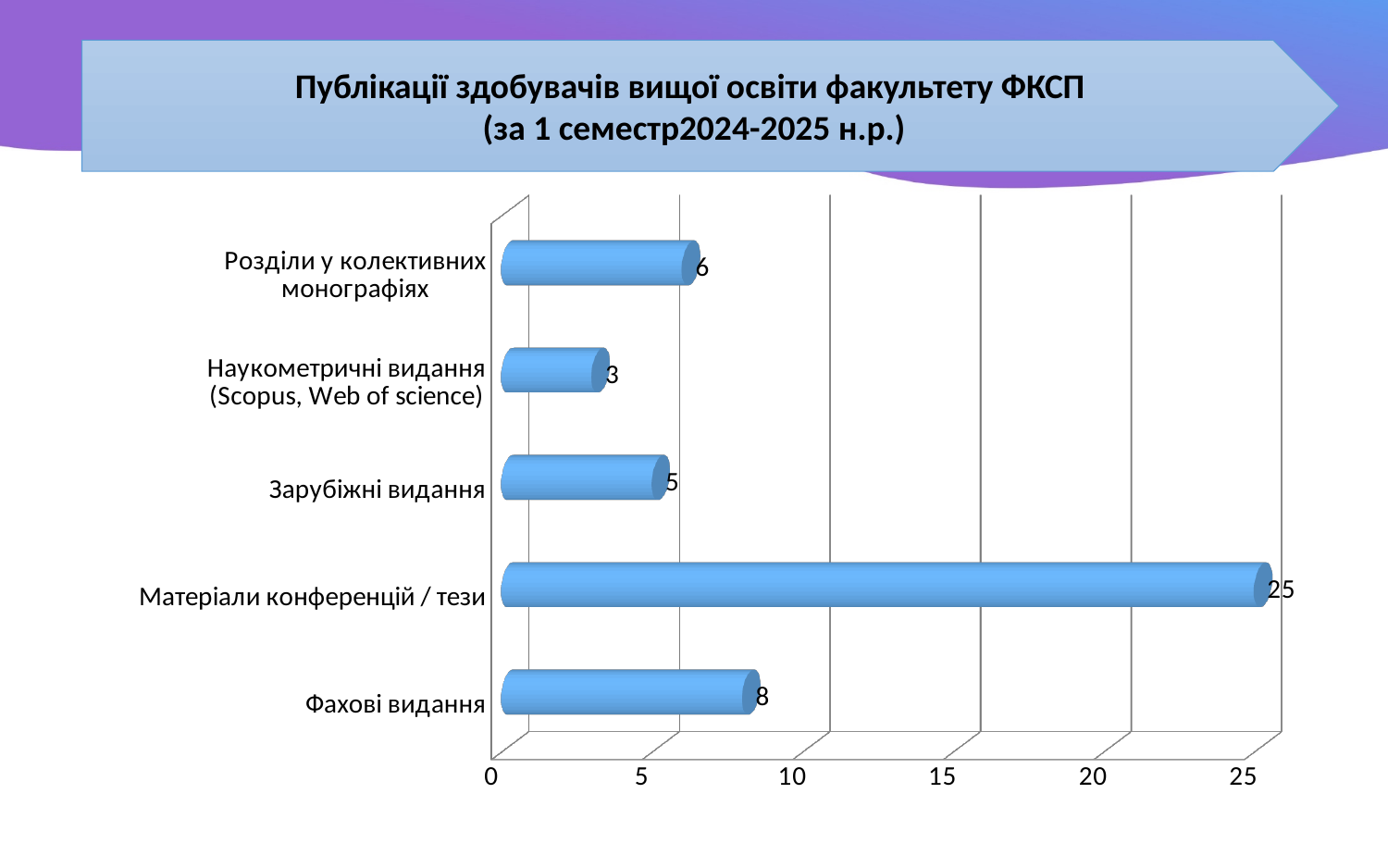
What is the title of the chart? Публікації здобувачів вищої освіти факультету ФКСП (за 1 семестр2024-2025 н.р.) Which is larger: the value for Розділи у колективних монографіях or the value for Зарубіжні видання? Розділи у колективних монографіях Which category has the highest value? Матеріали конференцій / тези How many categories are shown in the chart? 5 What is the difference between the values for Матеріали конференцій / тези and Фахові видання? 17 What is the value for Фахові видання? 8 What is the value for Зарубіжні видання? 5 What is the value for Наукометричні видання (Scopus, Web of science)? 3 Which category has the lowest value? Наукометричні видання (Scopus, Web of science) What kind of chart is shown on the slide? bar chart Is the value for Фахові видання greater or less than 10? less What is the value for Матеріали конференцій / тези? 25